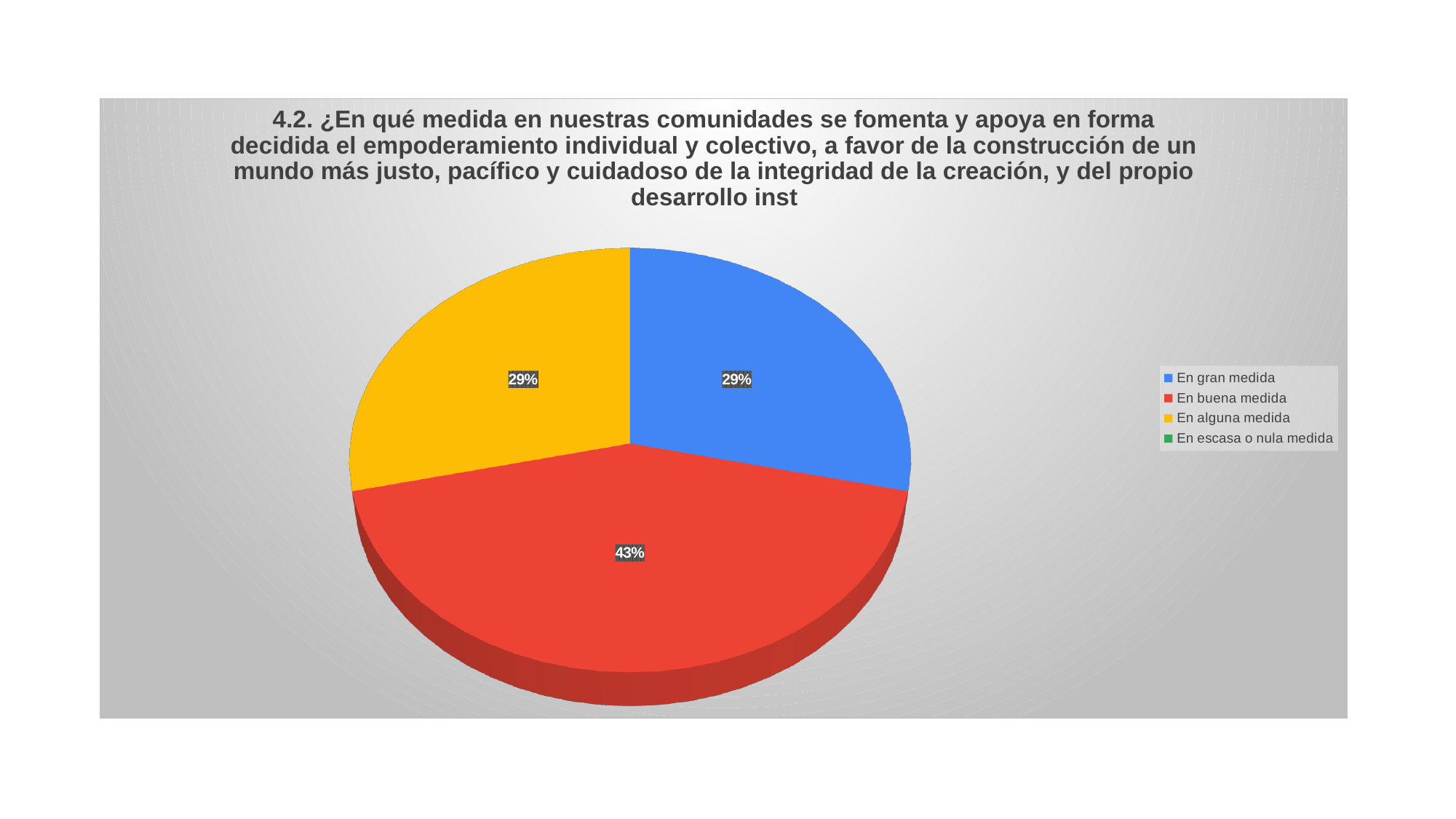
What type of chart is shown on the slide? Pie chart How many slices with visible data labels are shown in the pie? 3 What colour is the slice for 'En buena medida'? Red Which is larger, the share for 'En buena medida' or the share for 'En alguna medida'? En buena medida Which category has the largest slice of the pie? En buena medida What share of the pie does 'En buena medida' represent? 43% What share of the pie does 'En alguna medida' represent? 29% What is the difference between the share for 'En buena medida' and the share for 'En gran medida'? 14% What share of the pie does 'En gran medida' represent? 29% Which legend entry is shown in green? En escasa o nula medida How many entries does the legend list? 4